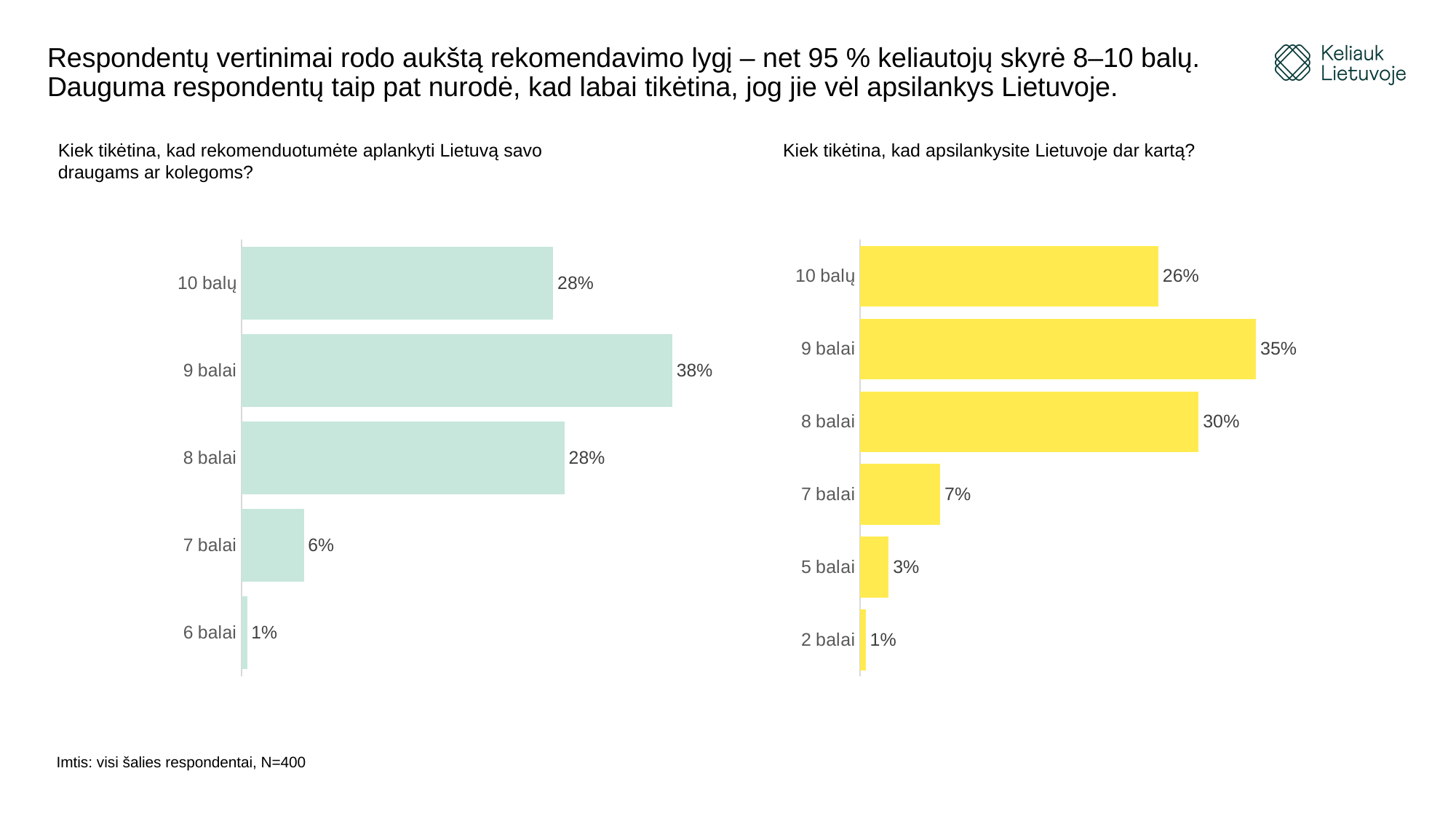
In the right chart, what is the difference between the percentages for 9 balai and 8 balai? 5% In the left chart, which score category has the highest percentage? 9 balai In the left chart (recommending Lithuania to friends or colleagues), what percentage of respondents gave 9 balai? 38% What type of chart is used on the left side of the slide? Bar chart In the left chart, what is the combined percentage for 10 balų, 9 balai and 8 balai? 94% In the right chart, what percentage of respondents gave 7 balai? 7% In the right chart (likelihood of visiting Lithuania again), what percentage of respondents gave 10 balų? 26% How many score categories are shown in the left chart? 5 In the right chart, which score category has the lowest percentage? 2 balai What colour are the bars in the right chart? Yellow In the left chart, which is larger: the percentage for 7 balai or for 6 balai? 7 balai How many score categories are shown in the right chart? 6